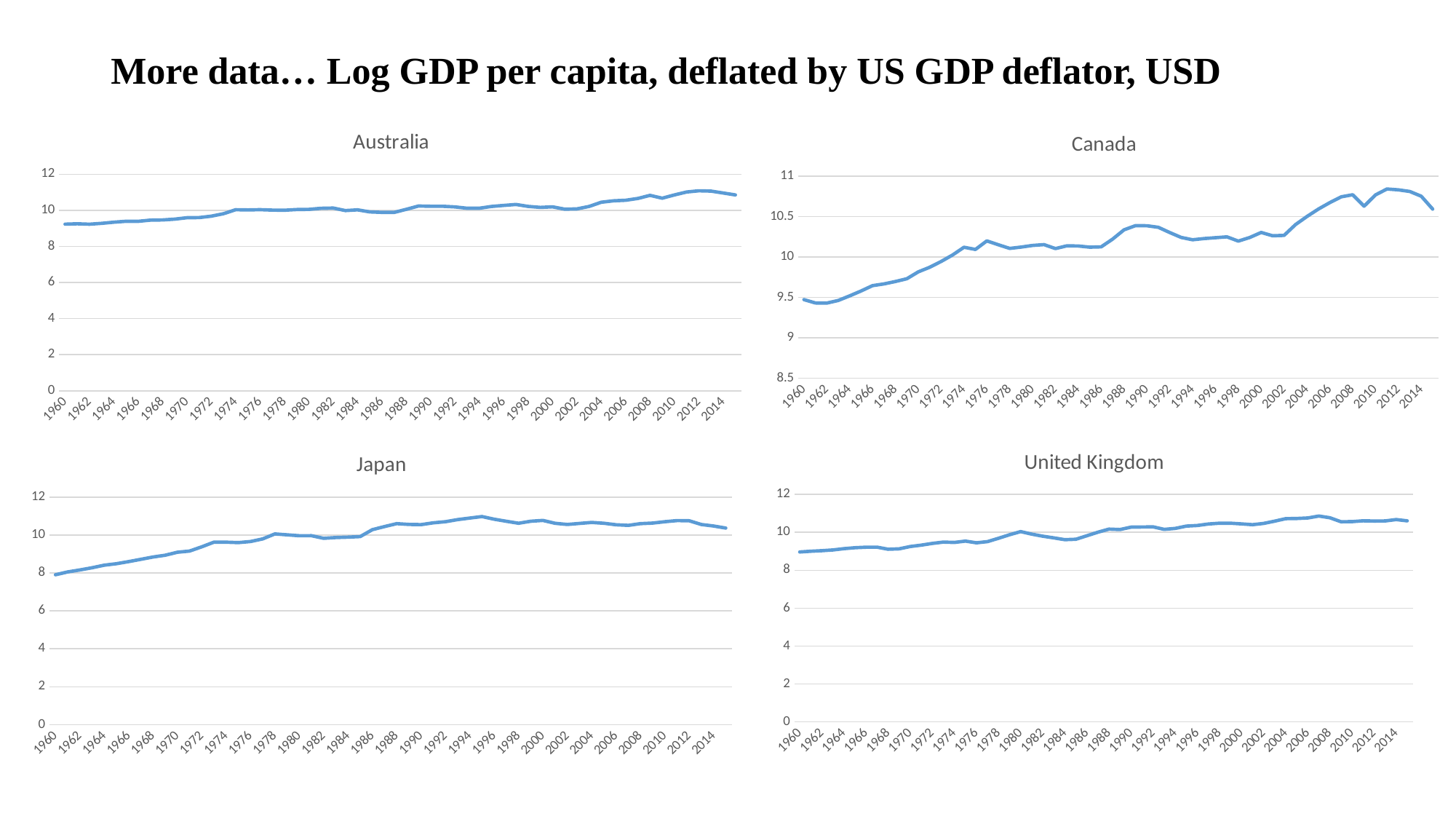
In the United Kingdom chart, does the value rise or fall overall from 1960 to 2014? rise In the United Kingdom chart, is the value for 1960 greater or less than 10? less What kind of chart is the Australia chart? line chart In the Japan chart, is the value for 1960 greater or less than 10? less In the Australia chart, is the value for 2012 greater or less than 10? greater In the Japan chart, does the value rise or fall overall from 1960 to 1996? rise What is the lowest value shown on the vertical axis of the Canada chart? 8.5 How many series does the Canada chart plot? 1 In the Canada chart, does the value rise or fall from 2012 to the last year shown? fall How many charts are shown on the slide? 4